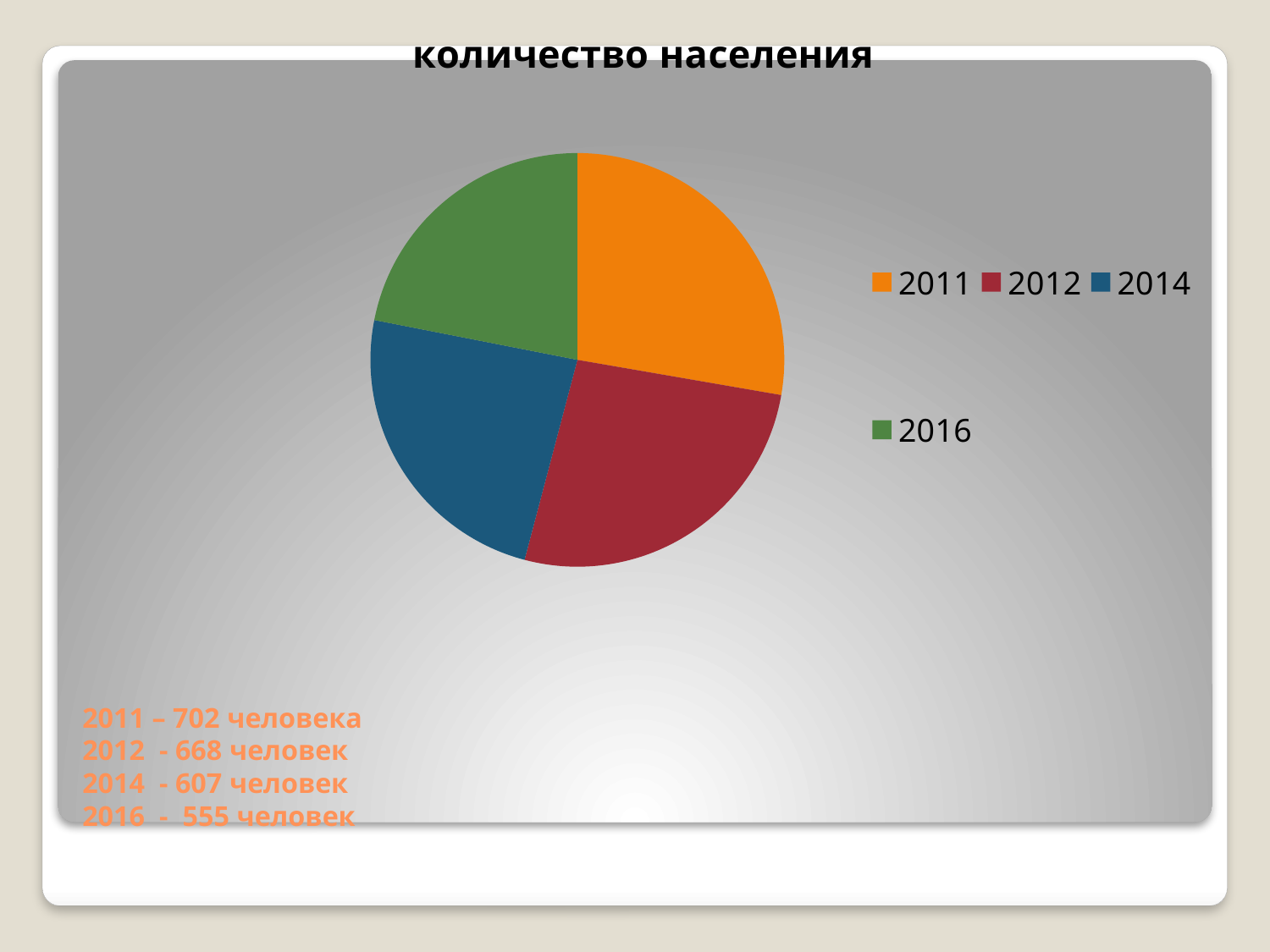
What is the difference between the population in 2011 and in 2016? 147 Which year has the largest slice of the pie? 2011 What is the population value given for 2016? 555 человек What kind of chart is shown on the slide? pie chart What is the population value given for 2014? 607 человек Which year has the smallest slice of the pie? 2016 How many slices does the pie chart have? 4 How many entries does the legend list? 4 What is the population value given for 2011? 702 человека Which is larger, the slice for 2012 or the slice for 2014? 2012 What is the title of the chart? количество населения Do the population values rise or fall from 2011 to 2016? fall